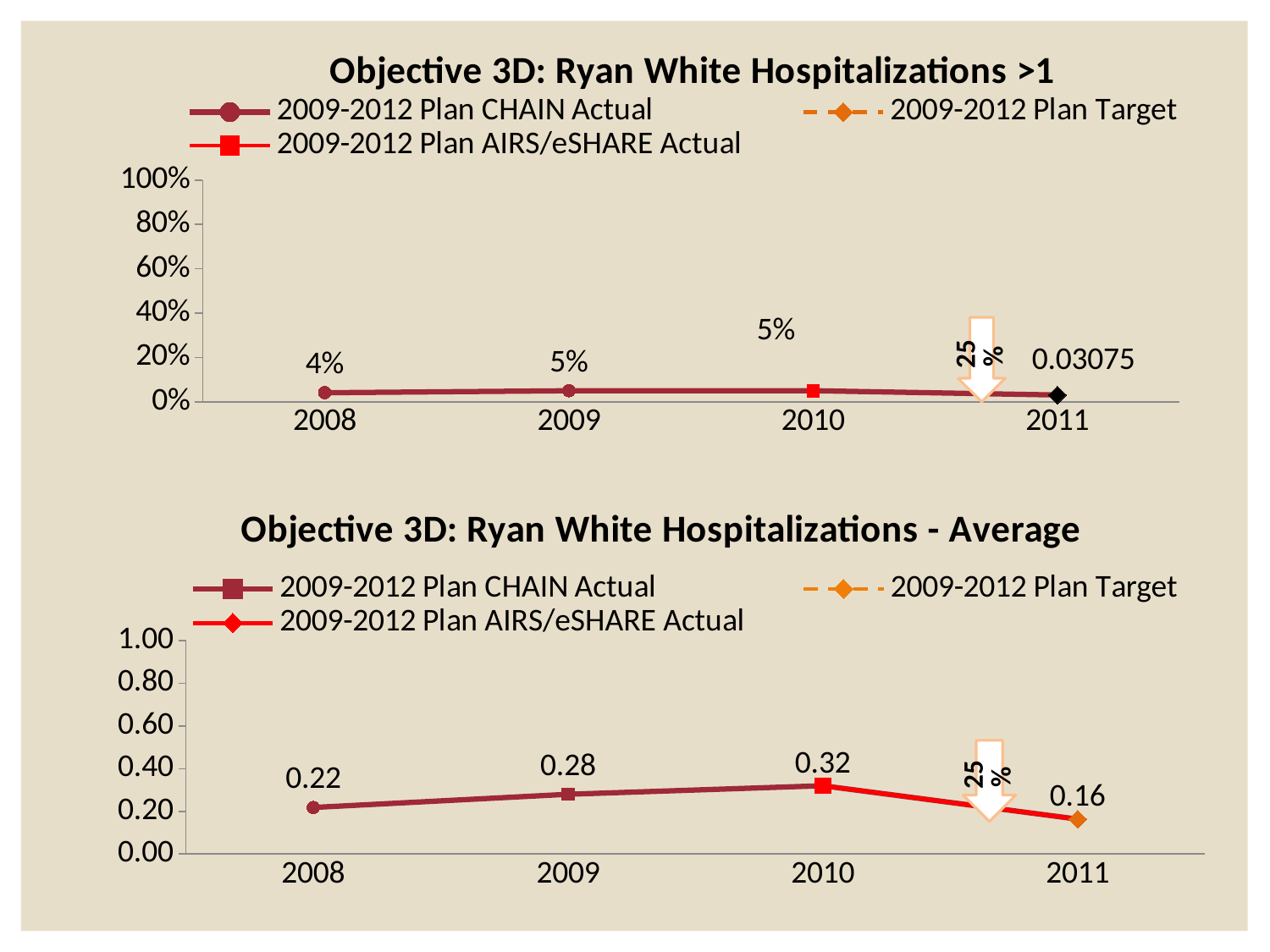
What kind of chart is the chart titled "Objective 3D: Ryan White Hospitalizations - Average"? Line chart In the chart titled "Objective 3D: Ryan White Hospitalizations - Average", what is the value for 2011? 0.16 In the chart titled "Objective 3D: Ryan White Hospitalizations >1", is the value for 2010 greater or less than 20%? less In the chart titled "Objective 3D: Ryan White Hospitalizations - Average", which year has the highest value? 2010 In the chart titled "Objective 3D: Ryan White Hospitalizations >1", what is the value labelled for 2008? 4% In the chart titled "Objective 3D: Ryan White Hospitalizations >1", what value is labelled at 2011? 0.03075 In the chart titled "Objective 3D: Ryan White Hospitalizations >1", what is the value labelled for 2009? 5% In the chart titled "Objective 3D: Ryan White Hospitalizations >1", how many series does the legend list? 3 In the chart titled "Objective 3D: Ryan White Hospitalizations - Average", what is the value for 2010? 0.32 In the chart titled "Objective 3D: Ryan White Hospitalizations - Average", which year has the lowest value? 2011 In the chart titled "Objective 3D: Ryan White Hospitalizations - Average", what is the difference between the 2010 value and the 2011 value? 0.16 In the chart titled "Objective 3D: Ryan White Hospitalizations - Average", how many years are shown on the x axis? 4